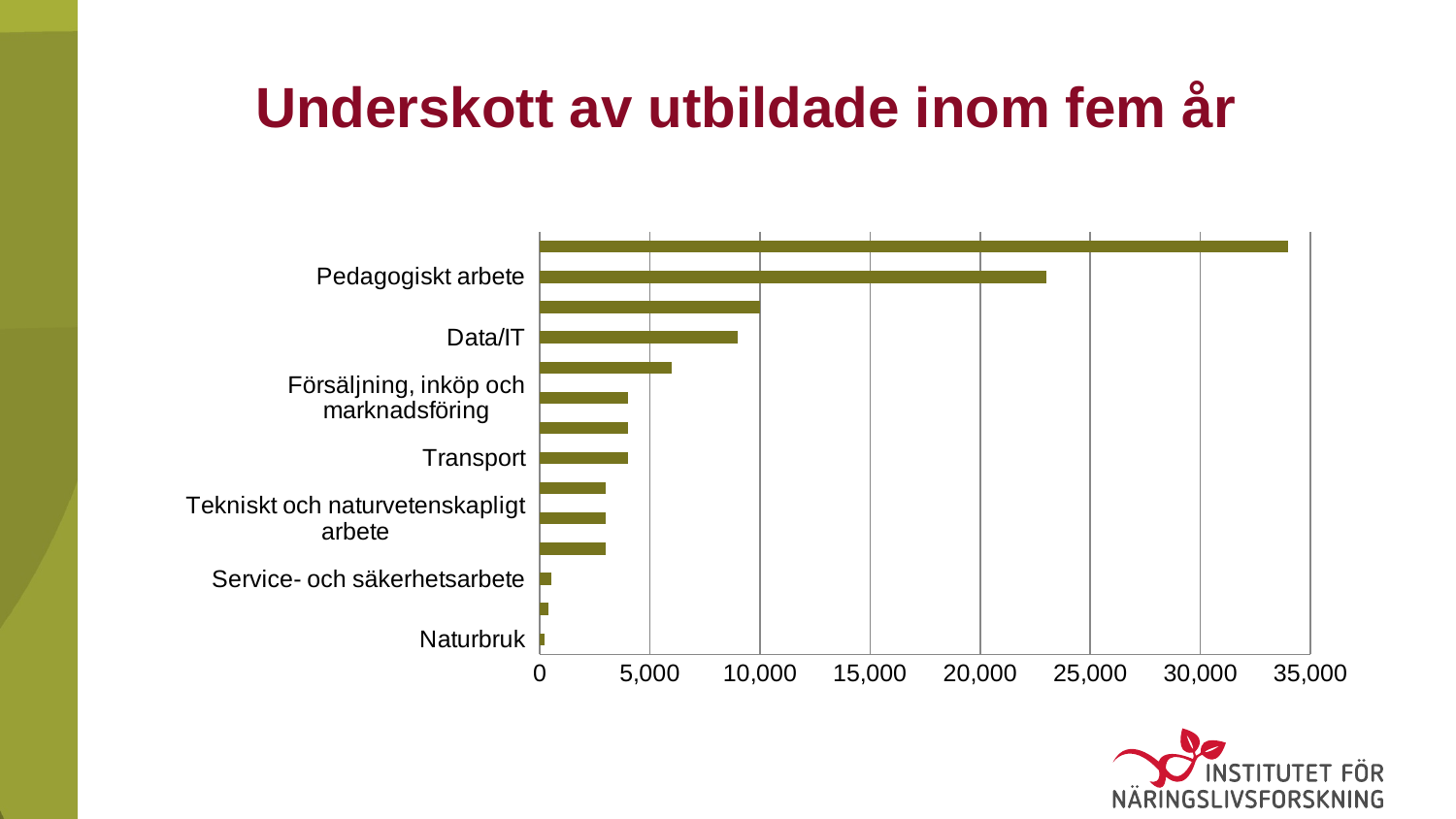
What is the highest value shown on the horizontal axis? 35,000 Is the value for Naturbruk greater or less than 5,000? less Which of the labelled categories has the highest value? Pedagogiskt arbete What kind of chart is shown on the slide? bar chart Is the value for Tekniskt och naturvetenskapligt arbete greater or less than 5,000? less What is the title of the chart? Underskott av utbildade inom fem år Is the value for Data/IT greater or less than 10,000? less Which has the larger value, Pedagogiskt arbete or Data/IT? Pedagogiskt arbete Which has the larger value, Data/IT or Transport? Data/IT Which of the labelled categories has the lowest value? Naturbruk